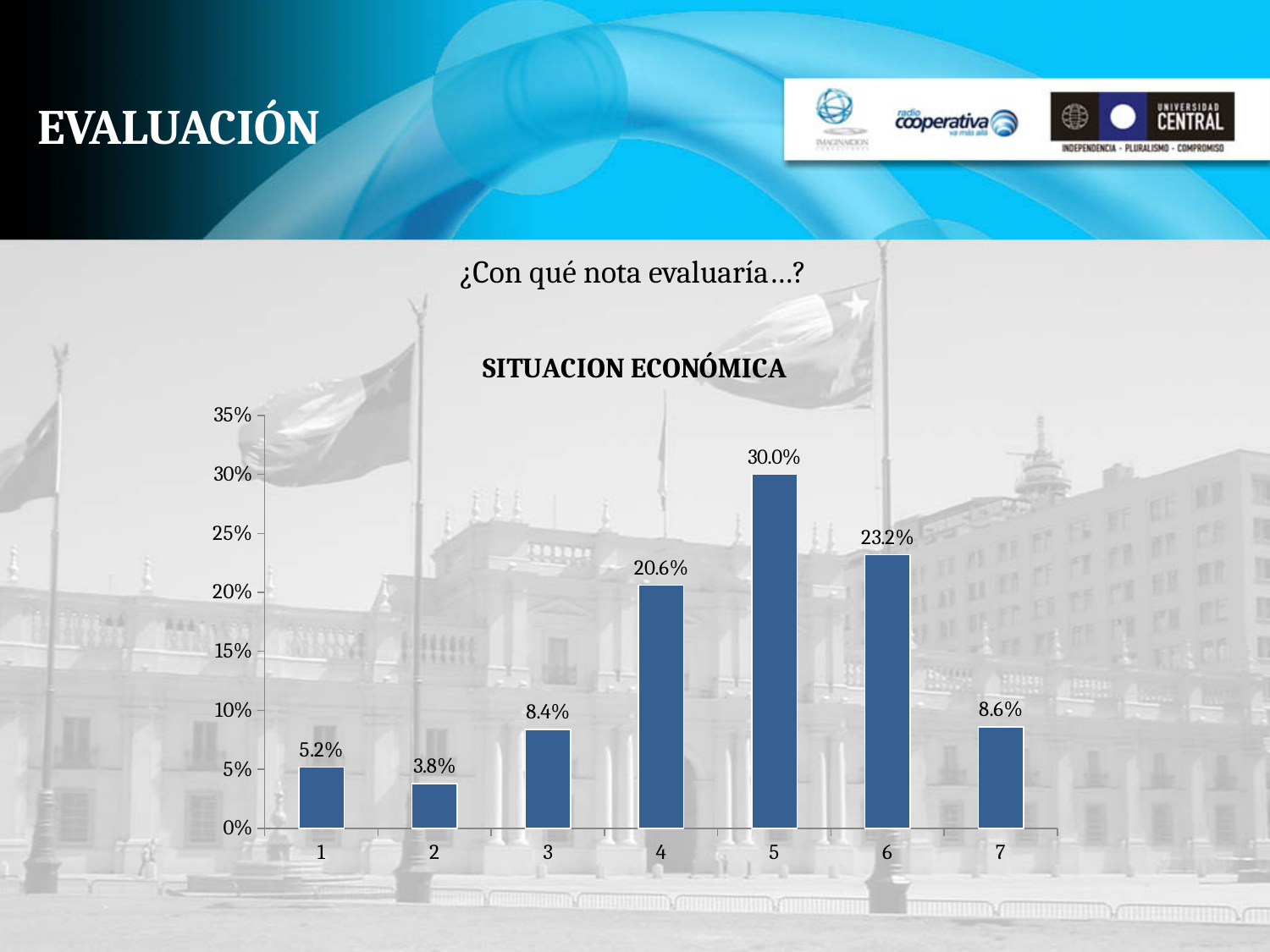
What is the value for category 2? 3.8% What is the difference between the values for category 4 and category 3? 12.2% Is the value for category 6 greater or less than 20%? greater What kind of chart is shown on the slide? bar chart Which is larger, the value for category 1 or the value for category 7? 7 What is the title of the chart? SITUACION ECONÓMICA Which category has the highest value? 5 What is the value for category 7? 8.6% What is the difference between the values for category 5 and category 6? 6.8% Which category has the lowest value? 2 What is the value for category 5? 30.0% How many categories are shown on the x axis? 7